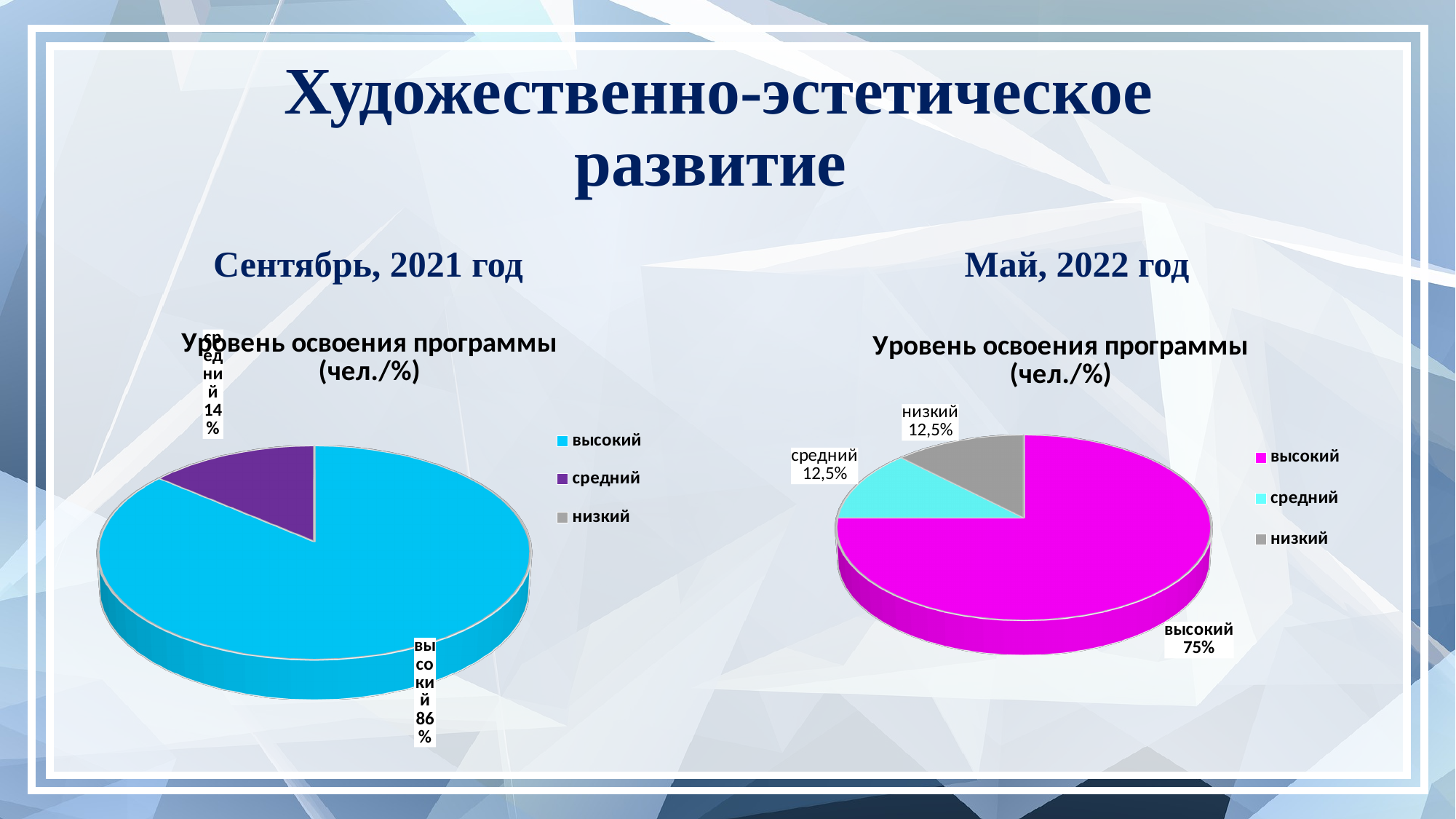
In the chart under "Сентябрь, 2021 год", what is the difference between the высокий and средний values? 72% What type of chart is shown under "Май, 2022 год"? pie chart Which is larger: высокий in the chart under "Сентябрь, 2021 год" or высокий in the chart under "Май, 2022 год"? Сентябрь, 2021 год In the chart under "Май, 2022 год", what is the value for высокий? 75% In the chart under "Май, 2022 год", which category has the largest slice? высокий In the chart under "Май, 2022 год", what is the value for низкий? 12,5% In the chart under "Сентябрь, 2021 год", which category has the largest slice? высокий In the chart under "Сентябрь, 2021 год", what is the value for высокий? 86% How many entries does the legend of the chart under "Сентябрь, 2021 год" list? 3 In the chart under "Май, 2022 год", what is the value for средний? 12,5% In the chart under "Сентябрь, 2021 год", what is the value for средний? 14% In the chart under "Май, 2022 год", what is the difference between the высокий and низкий values? 62,5%